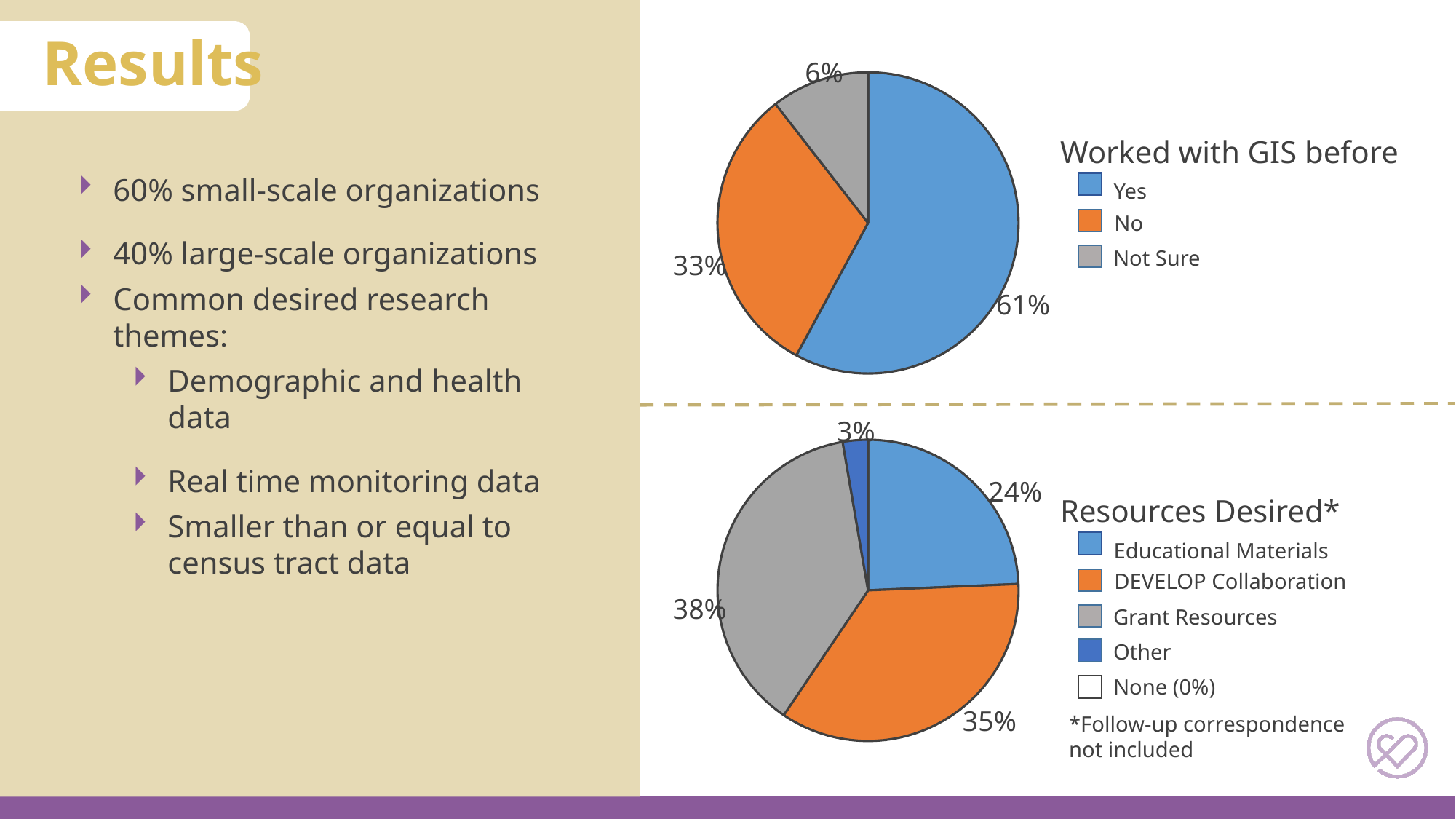
In the 'Worked with GIS before' chart, what is the difference between the Yes and No shares? 28% In the 'Worked with GIS before' chart, how many categories does the legend list? 3 In the 'Resources Desired*' chart, what percentage is Other? 3% What kind of chart is the 'Resources Desired*' chart? Pie chart In the 'Worked with GIS before' chart, which category has the largest share? Yes In the 'Worked with GIS before' chart, what percentage answered Yes? 61% In the 'Worked with GIS before' chart, what percentage answered Not Sure? 6% In the 'Resources Desired*' chart, what percentage is Grant Resources? 38% In the 'Resources Desired*' chart, which is larger: Educational Materials or DEVELOP Collaboration? DEVELOP Collaboration In the 'Resources Desired*' chart, what percentage does the legend give for None? 0% In the 'Resources Desired*' chart, what is the difference between Grant Resources and Educational Materials? 14% In the 'Resources Desired*' chart, which category has the smallest non-zero share? Other